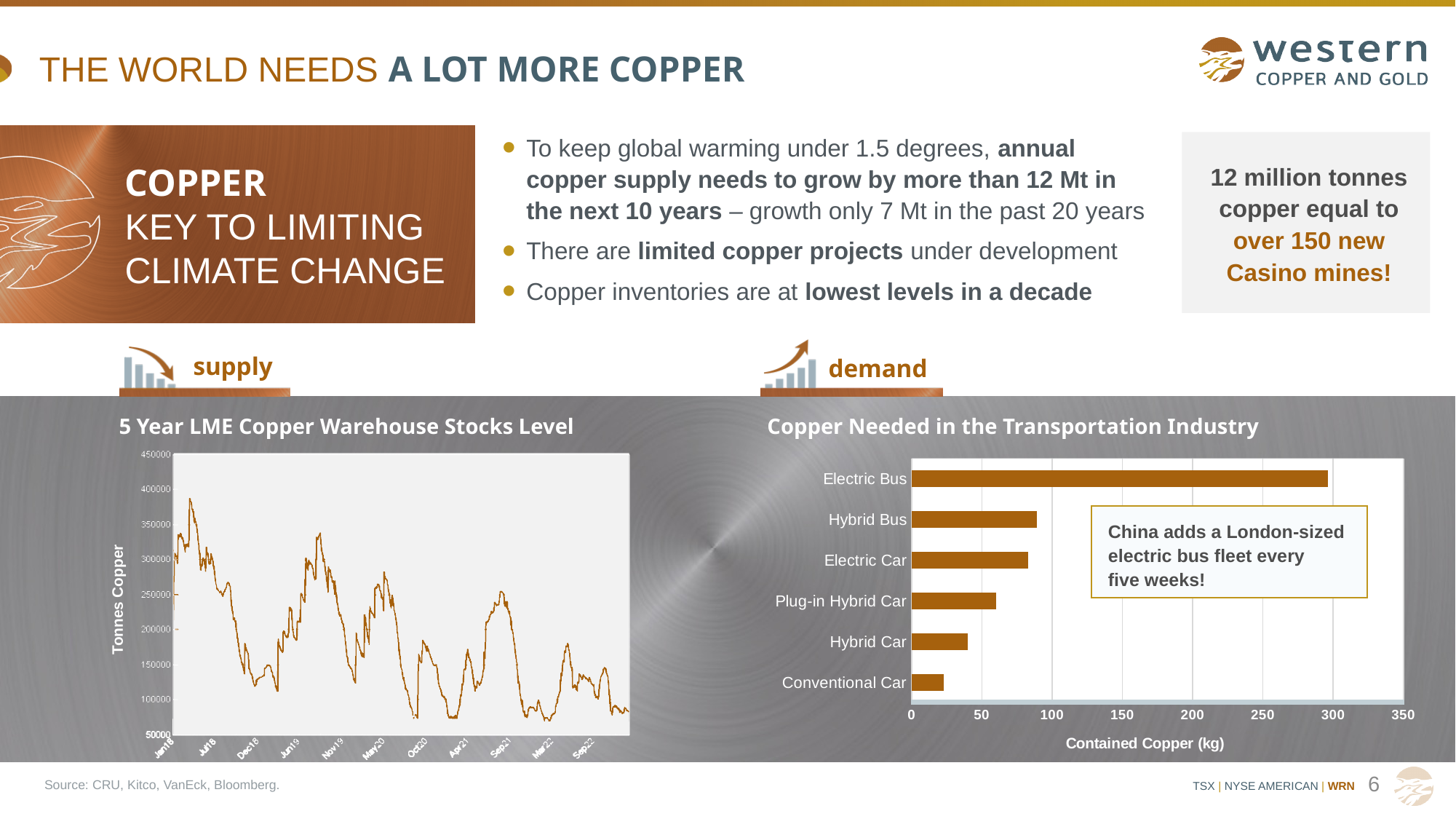
In the 'Copper Needed in the Transportation Industry' chart, which vehicle type needs the most contained copper? Electric Bus What is the x-axis label of the 'Copper Needed in the Transportation Industry' chart? Contained Copper (kg) What kind of chart is the 'Copper Needed in the Transportation Industry' chart? bar chart In the 'Copper Needed in the Transportation Industry' chart, which needs more contained copper, Electric Bus or Hybrid Bus? Electric Bus In the 'Copper Needed in the Transportation Industry' chart, is the value for Conventional Car greater or less than 50? less What kind of chart is the '5 Year LME Copper Warehouse Stocks Level' chart? line chart What is the y-axis label of the '5 Year LME Copper Warehouse Stocks Level' chart? Tonnes Copper In the 'Copper Needed in the Transportation Industry' chart, which vehicle type needs the least contained copper? Conventional Car In the 'Copper Needed in the Transportation Industry' chart, how many vehicle categories are shown? 6 In the 'Copper Needed in the Transportation Industry' chart, is the value for Hybrid Bus greater or less than 100? less In the 'Copper Needed in the Transportation Industry' chart, is the value for Plug-in Hybrid Car greater or less than 50? greater